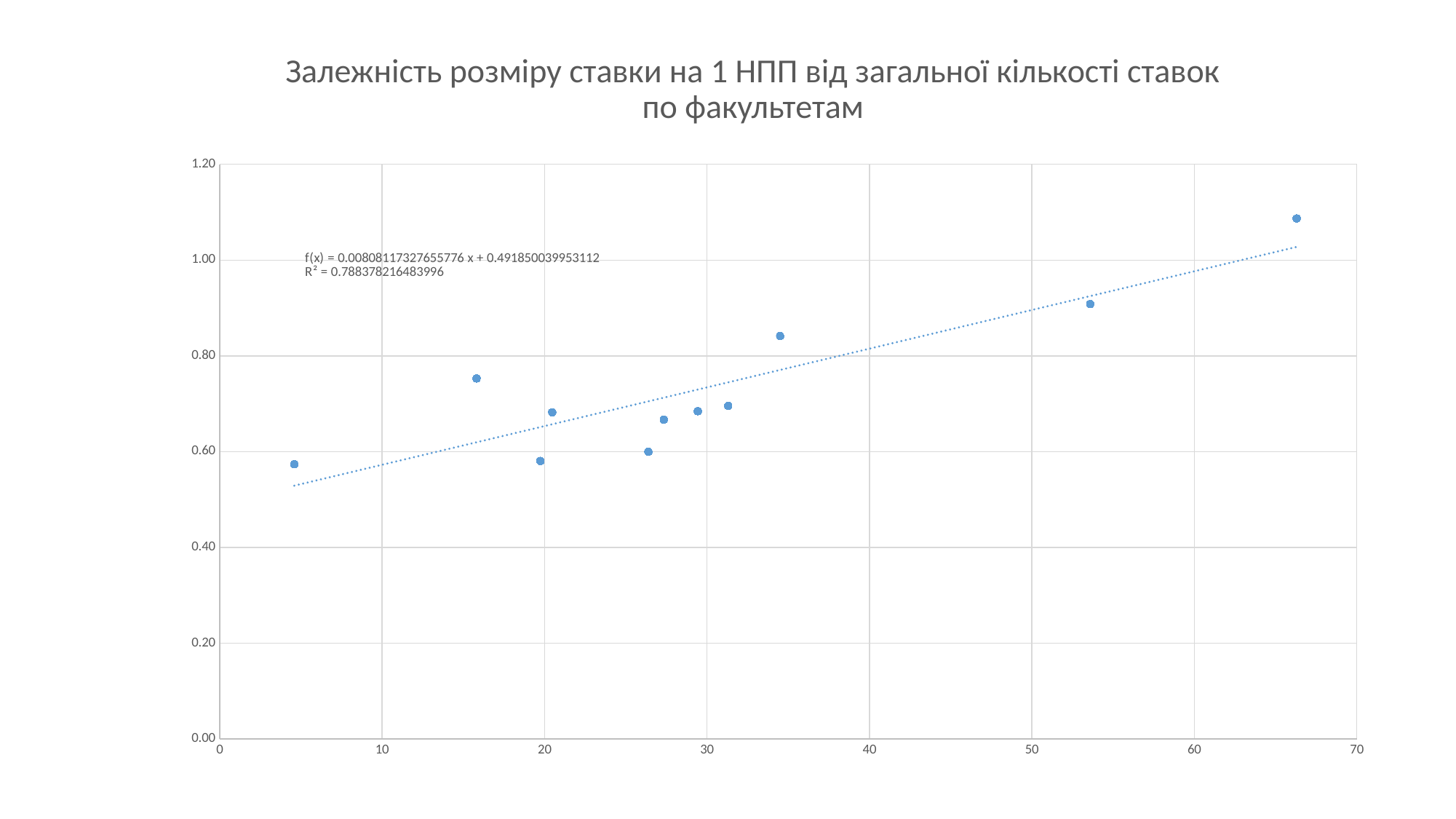
Is the y value of the data point near x = 16 greater or less than 0.70? greater What kind of chart is shown on the slide? Scatter chart Is the y value of the data point near x = 26 greater or less than 0.80? less Is the y value of the data point near x = 54 greater or less than 1.00? less What is the maximum value shown on the y axis? 1.20 What is the trendline equation shown on the chart? f(x) = 0.00808117327655776 x + 0.491850039953112 How many data points are plotted on the chart? 11 What is the R² value shown for the trendline? 0.788378216483996 Do the plotted values generally rise or fall as the x value increases? Rise